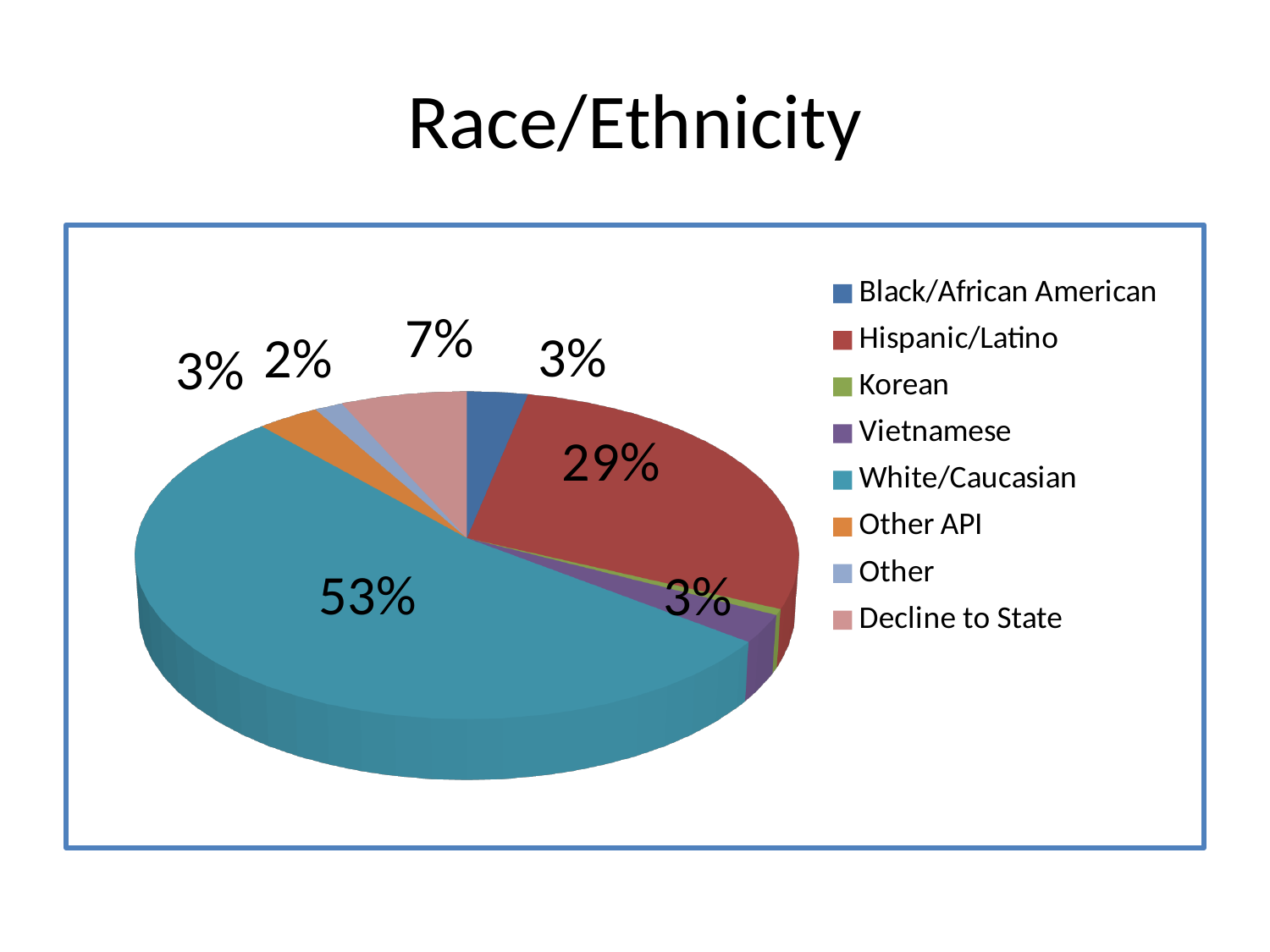
What percentage of the pie does Hispanic/Latino represent? 29% What kind of chart is shown on the slide? Pie chart What percentage is shown for Black/African American? 3% Which is larger, the share for Decline to State or the share for Other? Decline to State What percentage of the pie does White/Caucasian represent? 53% How many categories does the legend list? 8 What percentage is shown for Decline to State? 7% How many percentage points larger is the White/Caucasian share than the Hispanic/Latino share? 24 What is the title of the slide? Race/Ethnicity Which category has the largest share of the pie? White/Caucasian What percentage is shown for Other? 2% Is the share for White/Caucasian greater or less than 50%? greater